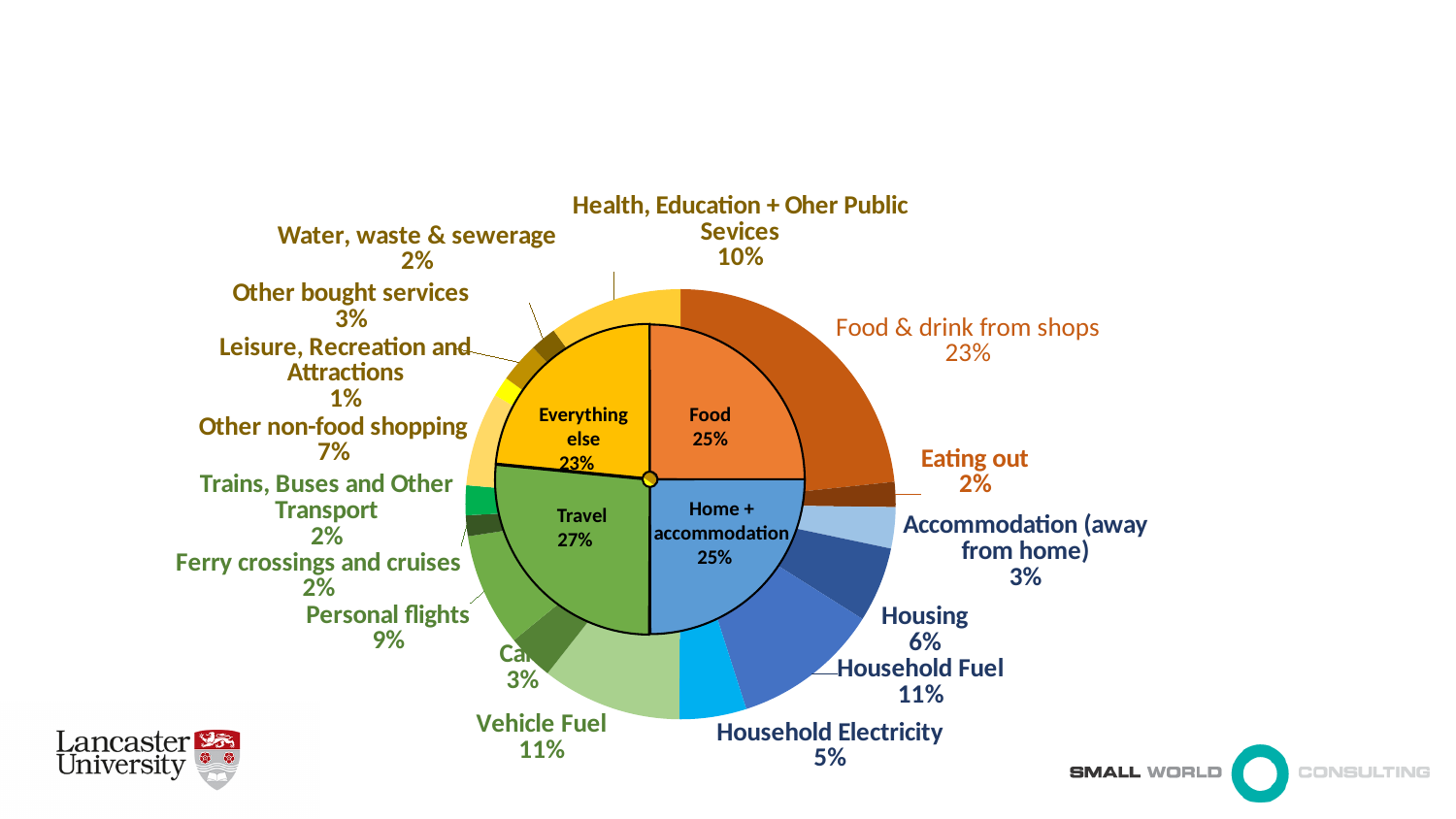
What is the combined share of Food and Home + accommodation in the inner ring? 50% What is the difference between the shares of Food & drink from shops and Eating out? 21% What percentage is shown for Food & drink from shops? 23% Which inner-ring category has the smallest share? Everything else How many categories are shown in the inner ring? 4 Which is larger, Housing or Household Electricity? Housing Which inner-ring category has the largest share? Travel What percentage is shown for Household Fuel? 11% Which outer-ring category has the smallest share? Leisure, Recreation and Attractions What share does Travel have in the inner ring? 27% What percentage is shown for Personal flights? 9% What kind of chart is shown on the slide? Pie chart